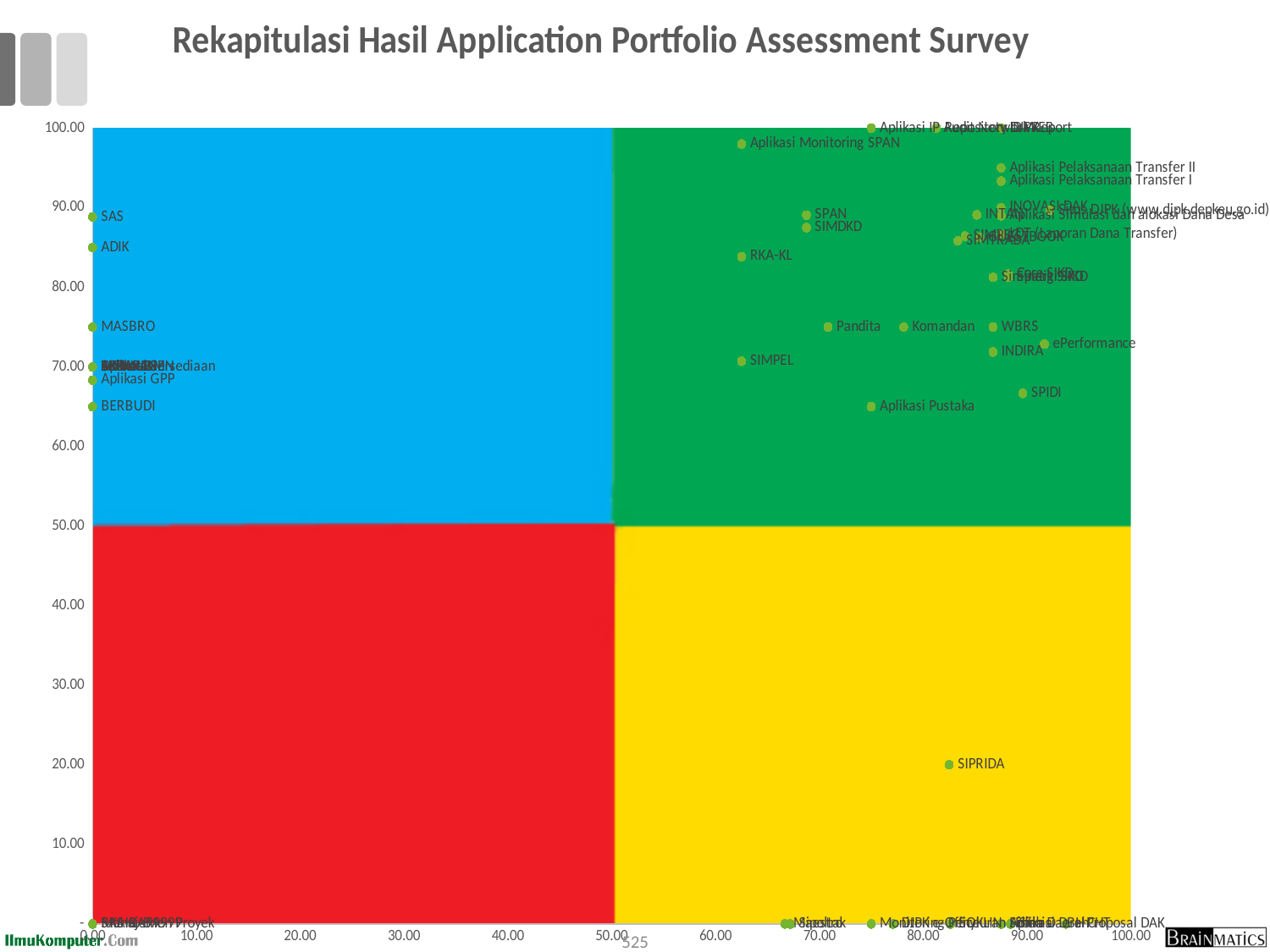
Which point is further right on the horizontal axis, SIMPEL or WBRS? WBRS Is the vertical-axis value for SIPRIDA greater or less than 30? less In which coloured quadrant does the SIPRIDA point lie? yellow (bottom right) Is the horizontal-axis value for RKA-KL greater or less than 50? greater Which point is higher on the vertical axis, Aplikasi Monitoring SPAN or RKA-KL? Aplikasi Monitoring SPAN Is the vertical-axis value for Aplikasi Monitoring SPAN greater or less than 90? greater What kind of chart is shown on the slide? scatter chart Which point is higher on the vertical axis, SAS or BERBUDI? SAS What is the title of the chart? Rekapitulasi Hasil Application Portfolio Assessment Survey